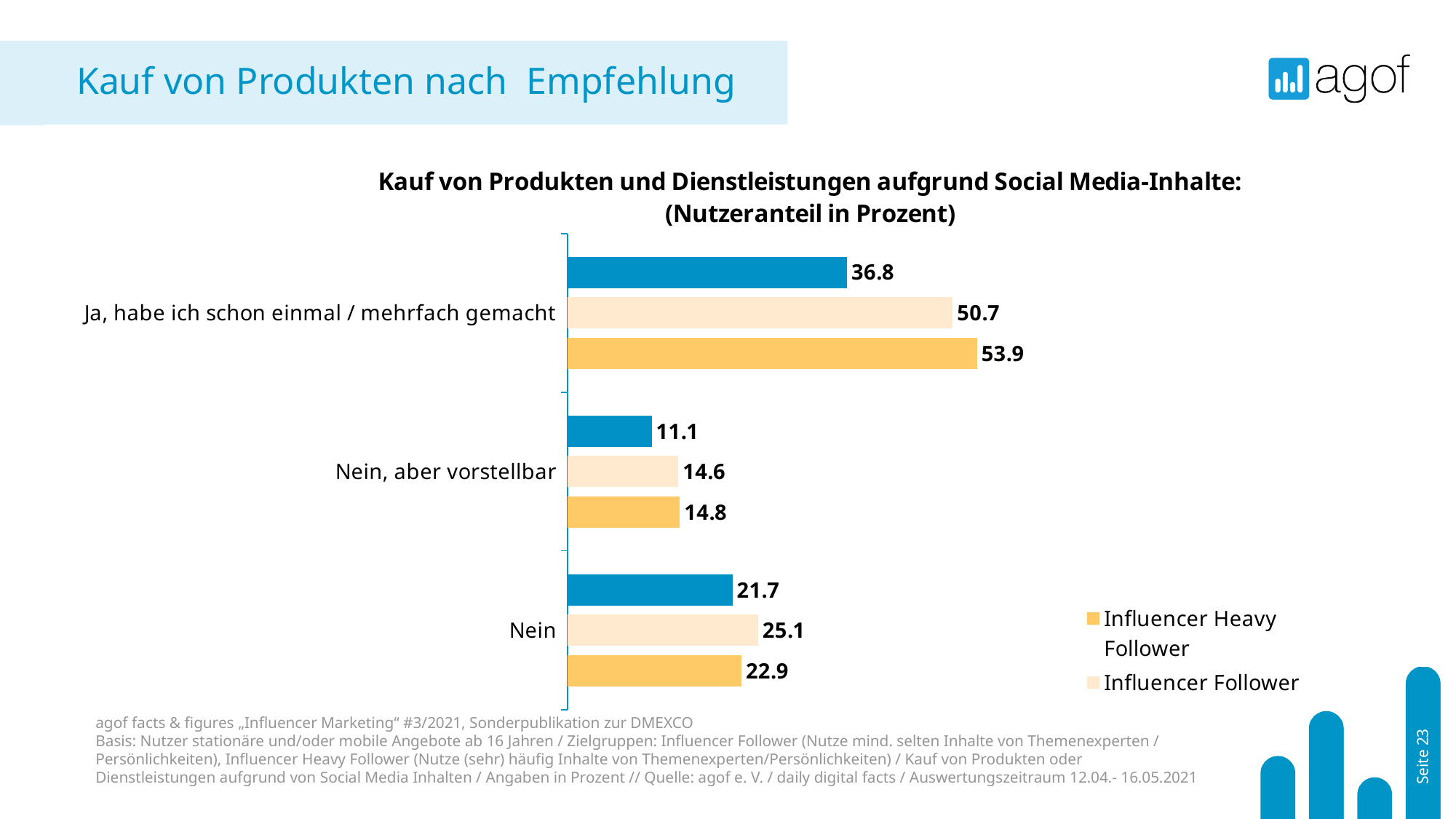
What is the value for Influencer Follower in the category "Nein"? 25.1 In the category "Nein", which is larger: the Influencer Follower value or the Influencer Heavy Follower value? Influencer Follower What is the difference between the Influencer Heavy Follower and Influencer Follower values in the category "Ja, habe ich schon einmal / mehrfach gemacht"? 3.2 Which category has the lowest value for Influencer Follower? Nein, aber vorstellbar How many series does the legend list? 2 Which category has the highest value for Influencer Heavy Follower? Ja, habe ich schon einmal / mehrfach gemacht How many categories are shown on the chart? 3 What is the title of the chart? Kauf von Produkten und Dienstleistungen aufgrund Social Media-Inhalte: (Nutzeranteil in Prozent) What is the value for Influencer Follower in the category "Nein, aber vorstellbar"? 14.6 What is the value for Influencer Heavy Follower in the category "Ja, habe ich schon einmal / mehrfach gemacht"? 53.9 What kind of chart is shown on the slide? Bar chart What is the value for Influencer Heavy Follower in the category "Nein"? 22.9